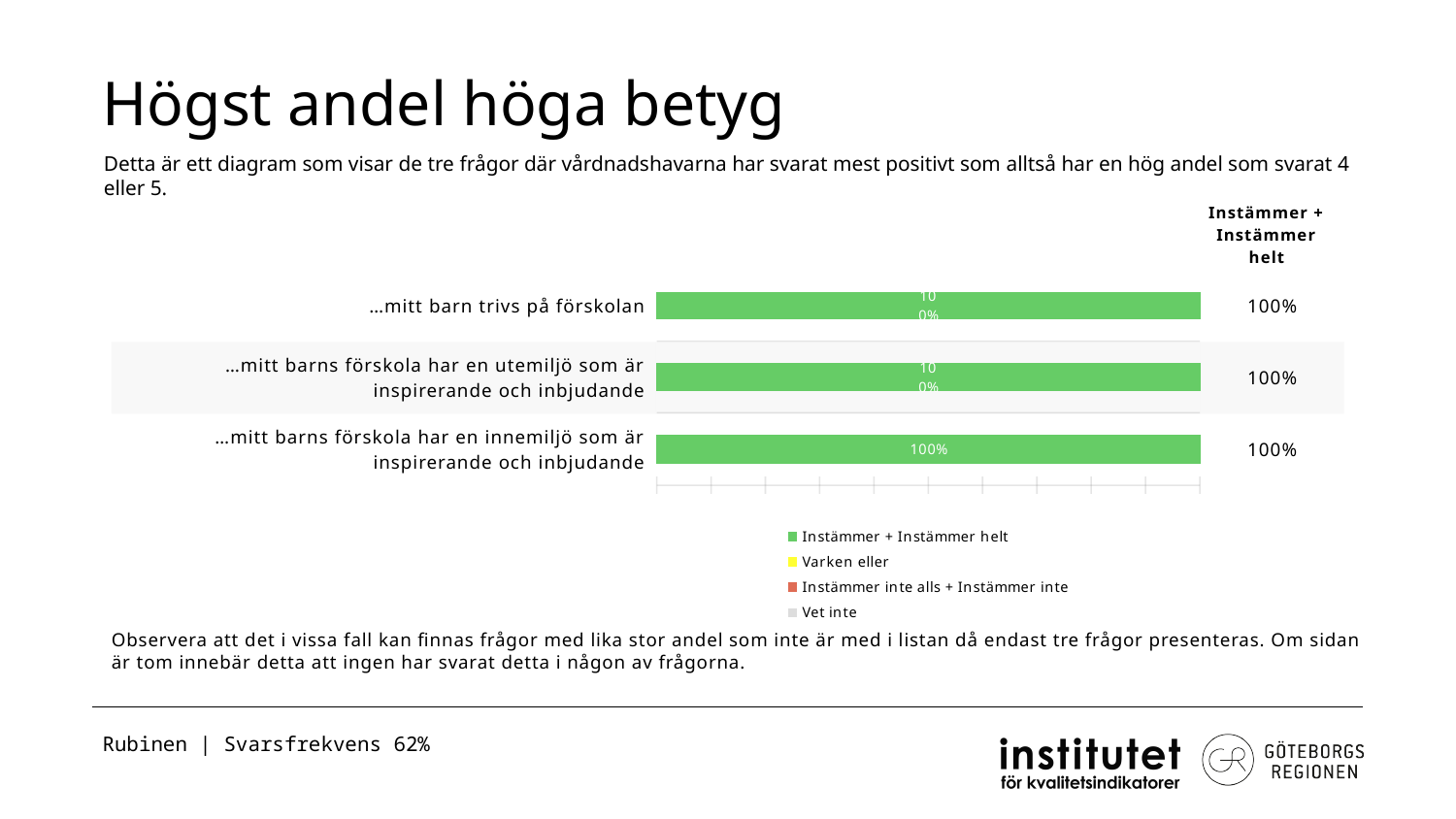
What is the difference between the 'Instämmer + Instämmer helt' values for '…mitt barn trivs på förskolan' and '…mitt barns förskola har en innemiljö som är inspirerande och inbjudande'? 0% What is the heading of the value column to the right of the bars? Instämmer + Instämmer helt How many series does the chart legend list? 4 Which legend entry is shown in yellow? Varken eller Which legend entry is shown in green? Instämmer + Instämmer helt What kind of chart is shown on the slide? bar chart Is the 'Instämmer + Instämmer helt' value for '…mitt barn trivs på förskolan' greater or less than 50%? greater What is the 'Instämmer + Instämmer helt' value for '…mitt barns förskola har en utemiljö som är inspirerande och inbjudande'? 100% What is the 'Instämmer + Instämmer helt' value for '…mitt barns förskola har en innemiljö som är inspirerande och inbjudande'? 100% What is the 'Instämmer + Instämmer helt' value for '…mitt barn trivs på förskolan'? 100% How many questions (categories) are plotted in the chart? 3